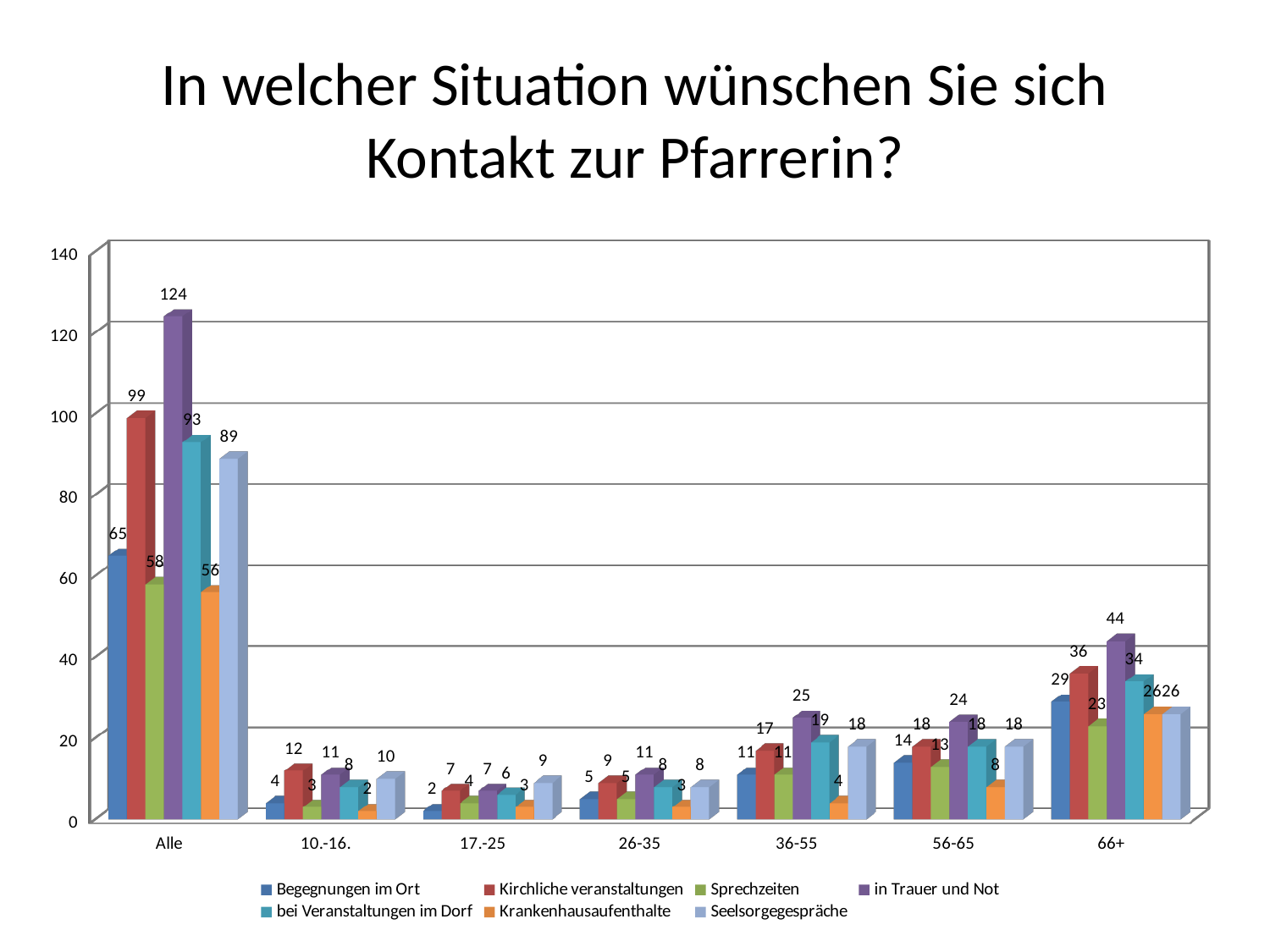
Which series has the highest value in the 'Alle' category? in Trauer und Not In the 'Alle' category, what is the difference between 'in Trauer und Not' and 'Kirchliche veranstaltungen'? 25 In the '66+' category, what is the difference between 'in Trauer und Not' and 'Sprechzeiten'? 21 How many series does the legend list? 7 How many categories are shown on the x axis? 7 What is the value for 'Kirchliche veranstaltungen' in the '66+' category? 36 Which series has the lowest value in the 'Alle' category? Krankenhausaufenthalte In the '36-55' category, which is larger: 'in Trauer und Not' or 'bei Veranstaltungen im Dorf'? in Trauer und Not What is the title of the chart? In welcher Situation wünschen Sie sich Kontakt zur Pfarrerin? What kind of chart is shown on the slide? Bar chart What is the value for 'Seelsorgegespräche' in the '56-65' category? 18 What is the value for 'in Trauer und Not' in the 'Alle' category? 124